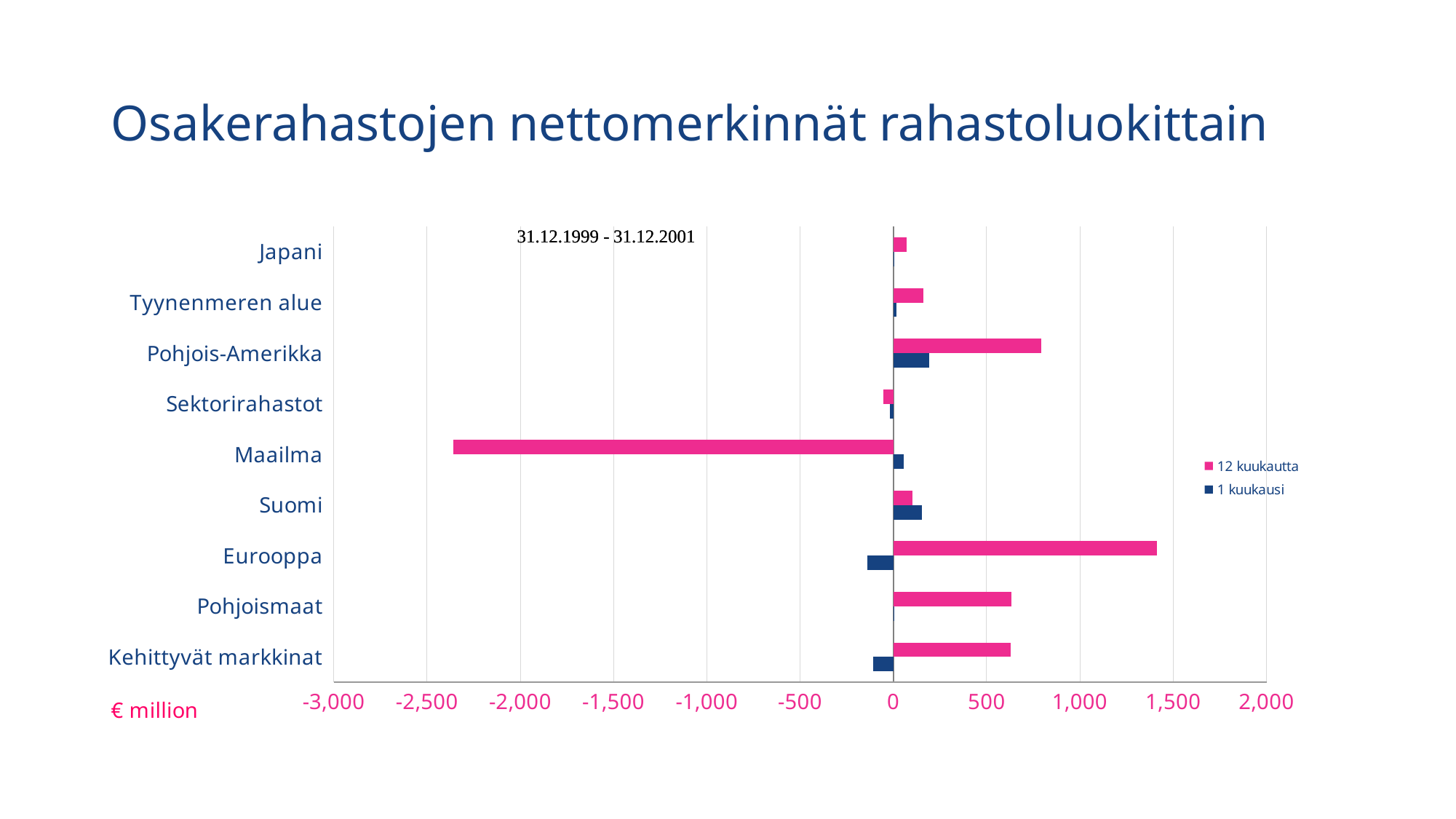
Which is larger for the 12 kuukautta series: Pohjois-Amerikka or Suomi? Pohjois-Amerikka What is the title of the chart on the slide? Osakerahastojen nettomerkinnät rahastoluokittain Is the 12 kuukautta value for Eurooppa greater or less than 1,000? greater What kind of chart is shown on the slide? bar chart Is the 12 kuukautta value for Pohjoismaat greater or less than 500? greater Which category has the highest value for the 12 kuukautta series? Eurooppa Is the 12 kuukautta value for Pohjois-Amerikka greater or less than 500? greater How many fund categories are listed on the vertical axis of the chart? 9 Which category has the lowest value for the 12 kuukautta series? Maailma What unit is shown for the horizontal axis of the chart? € million How many series does the chart legend list? 2